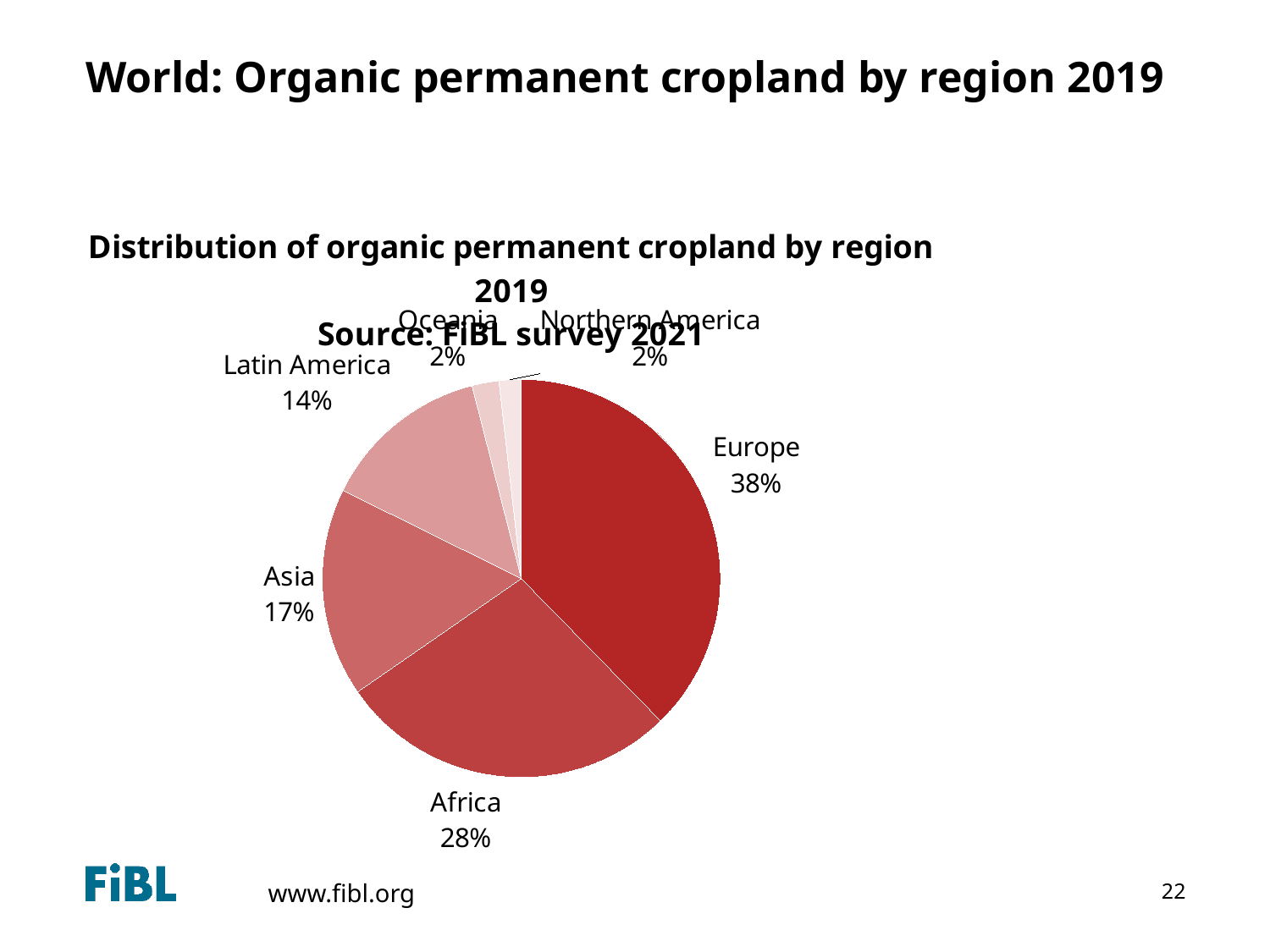
What source is cited for the chart? FiBL survey 2021 What share of organic permanent cropland does Oceania hold? 2% What is the difference in percentage points between Asia's and Latin America's shares? 3 How many regions are shown in the pie chart? 6 What is the difference in percentage points between Europe's and Africa's shares? 10 Which has a larger share, Asia or Latin America? Asia What share of organic permanent cropland does Africa hold? 28% What share of organic permanent cropland does Europe hold? 38% Which region has the largest share of organic permanent cropland? Europe What share of organic permanent cropland does Asia hold? 17% What kind of chart is shown on the slide? Pie chart What share of organic permanent cropland does Latin America hold? 14%